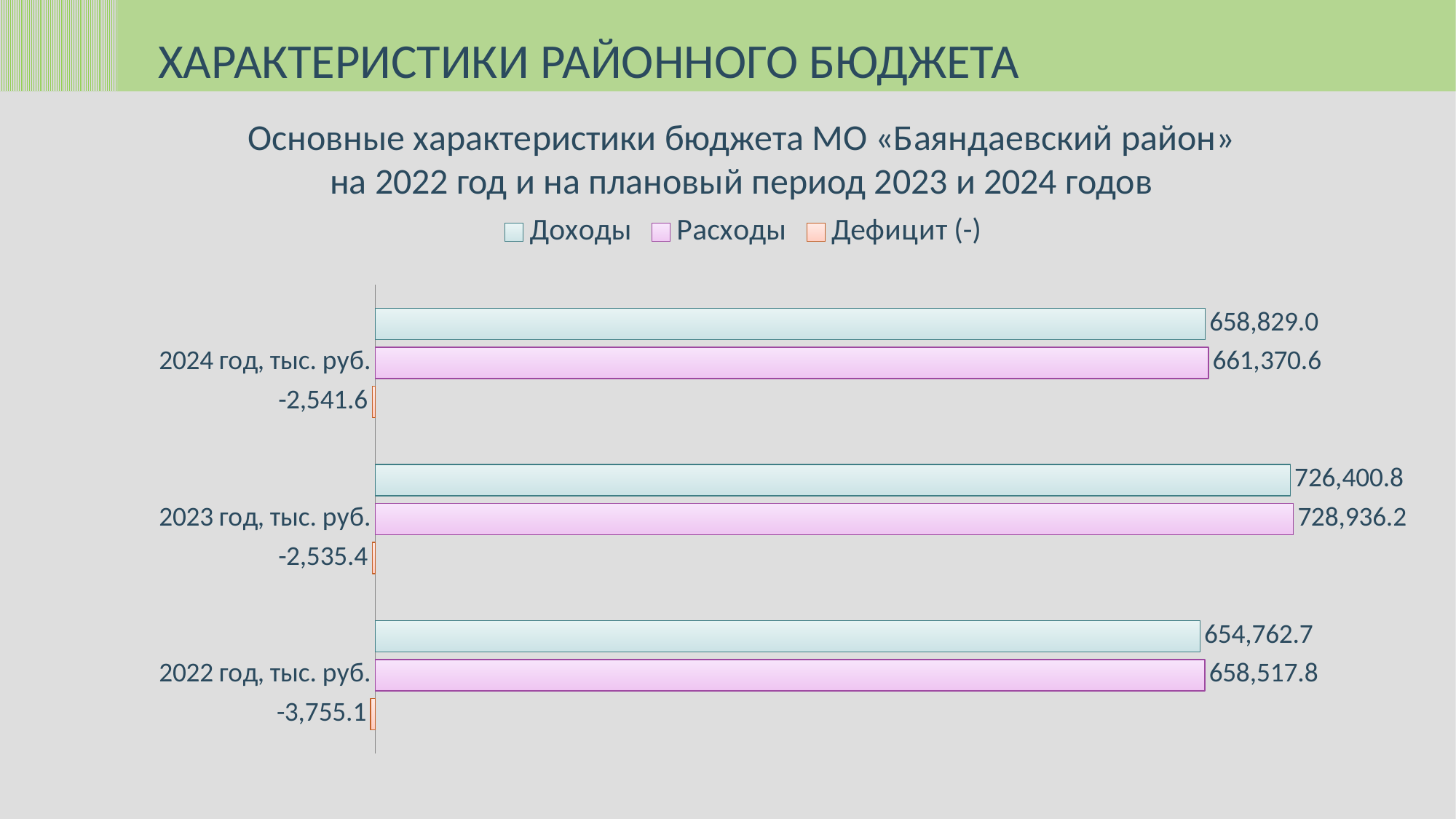
What is the difference between Доходы for 2023 год and Доходы for 2022 год? 71,638.1 What is the value of Дефицит (-) for 2024 год, тыс. руб.? -2,541.6 Which year has the highest value of Доходы? 2023 год, тыс. руб. What is the value of Расходы for 2022 год, тыс. руб.? 658,517.8 Which is larger for 2024 год, тыс. руб.: Доходы or Расходы? Расходы Which year has the lowest value of Расходы? 2022 год, тыс. руб. What is the difference between Расходы and Доходы for 2023 год, тыс. руб.? 2,535.4 What is the value of Доходы for 2023 год, тыс. руб.? 726,400.8 How many series does the legend list? 3 How many year categories are shown on the chart? 3 What is the value of Расходы for 2024 год, тыс. руб.? 661,370.6 What type of chart is shown on the slide? Bar chart